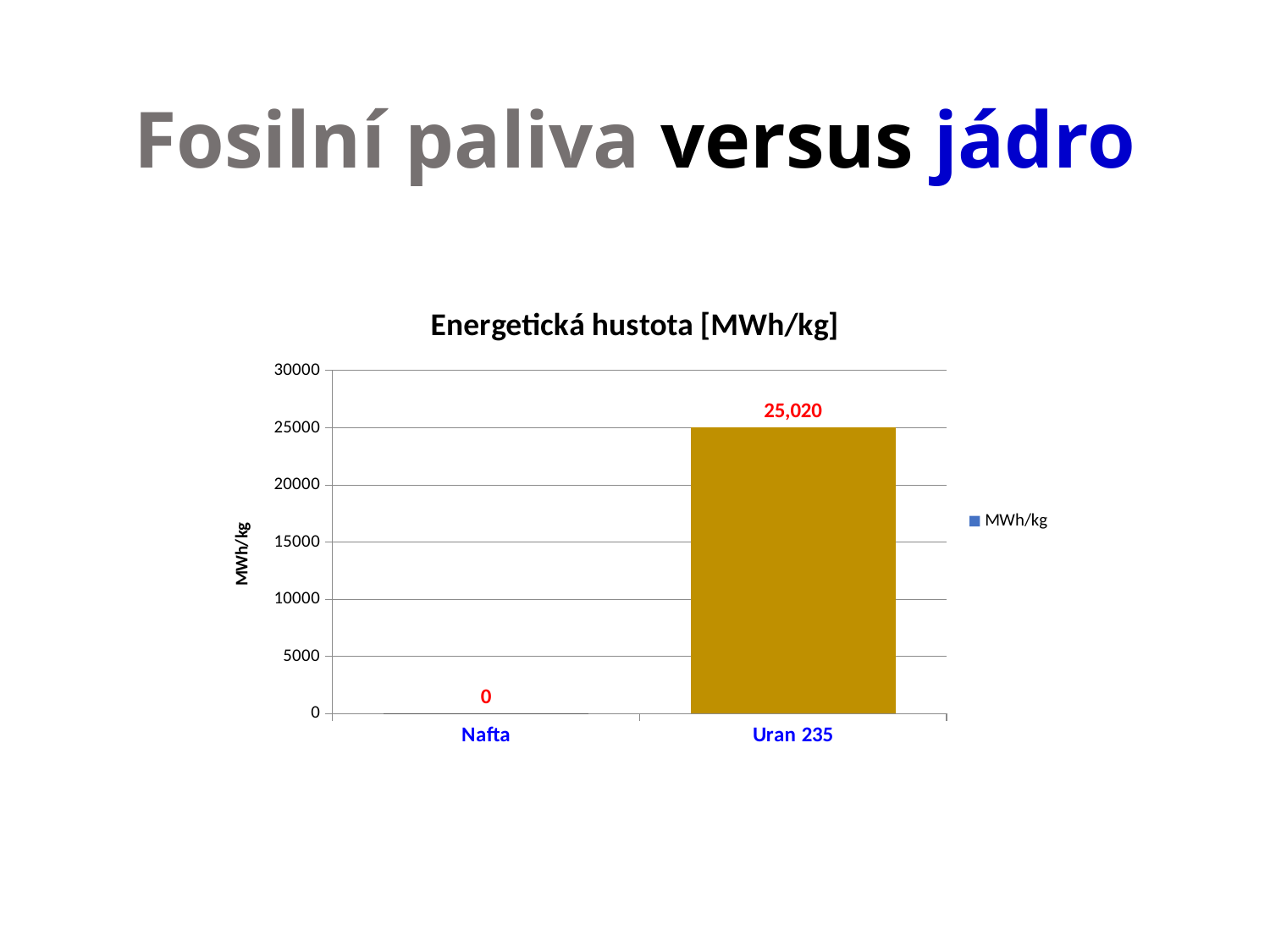
Is the value for Uran 235 greater or less than 20000? greater What is the title of the chart? Energetická hustota [MWh/kg] Which category has the highest value? Uran 235 Which is larger, the value for Nafta or the value for Uran 235? Uran 235 What is the label of the y axis? MWh/kg What kind of chart is shown? bar chart How many series does the legend list? 1 What is the value for Nafta? 0 What is the value for Uran 235? 25,020 What is the difference between the values for Uran 235 and Nafta? 25,020 How many categories are shown on the x axis? 2 Which category has the lowest value? Nafta